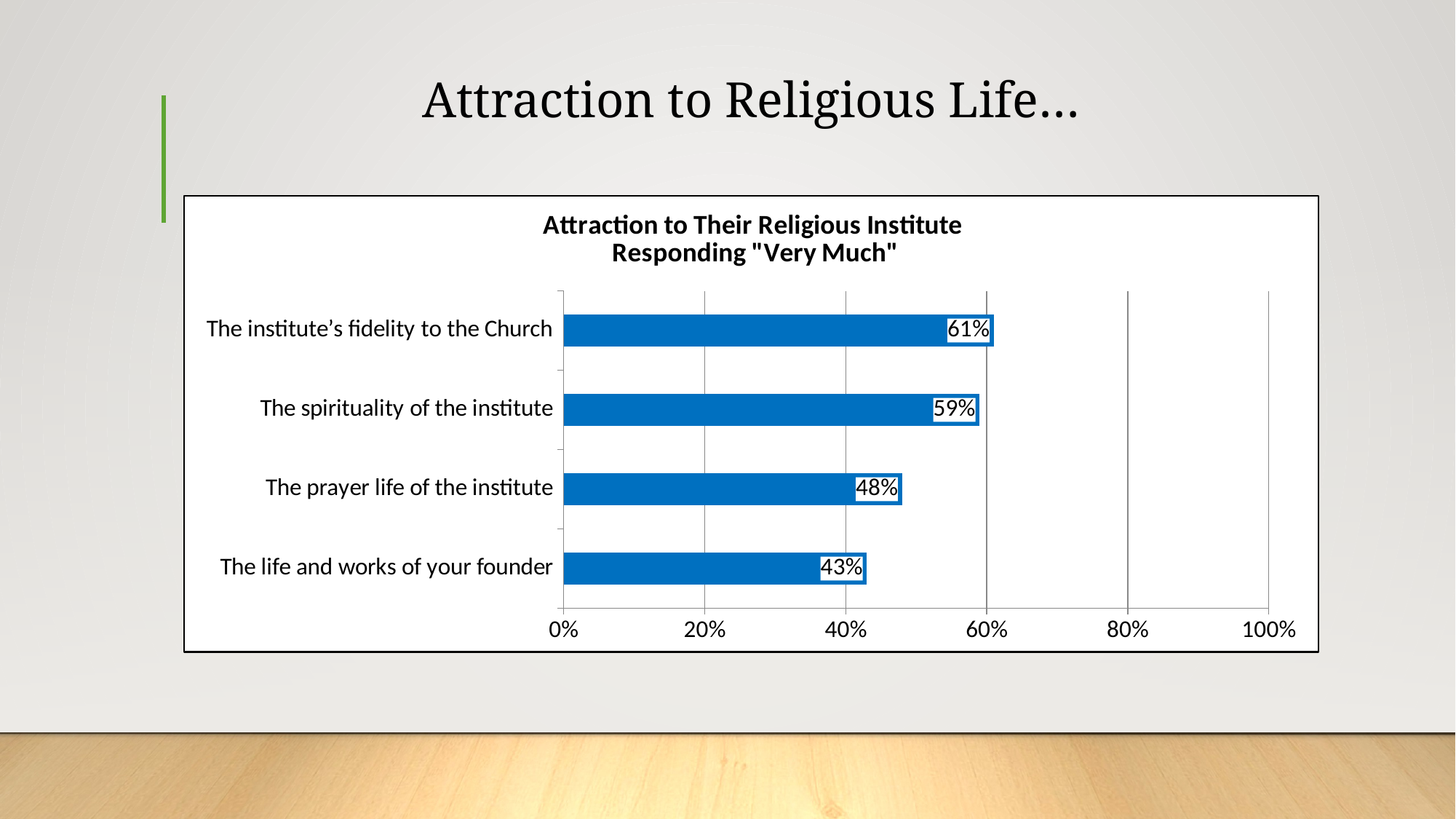
What is the difference between the values for the institute's fidelity to the Church and the life and works of your founder? 18% What percentage responded "Very Much" for the institute's fidelity to the Church? 61% Which category has the highest value? The institute's fidelity to the Church Which category has the lowest value? The life and works of your founder Is the value for the prayer life of the institute greater or less than 40%? greater How many categories are shown in the chart? 4 Which is larger: the value for the prayer life of the institute or the value for the life and works of your founder? The prayer life of the institute What is the value shown for the life and works of your founder? 43% What is the value shown for the spirituality of the institute? 59% What is the difference between the values for the spirituality of the institute and the prayer life of the institute? 11% What is the value shown for the prayer life of the institute? 48% What kind of chart is shown on the slide? Bar chart